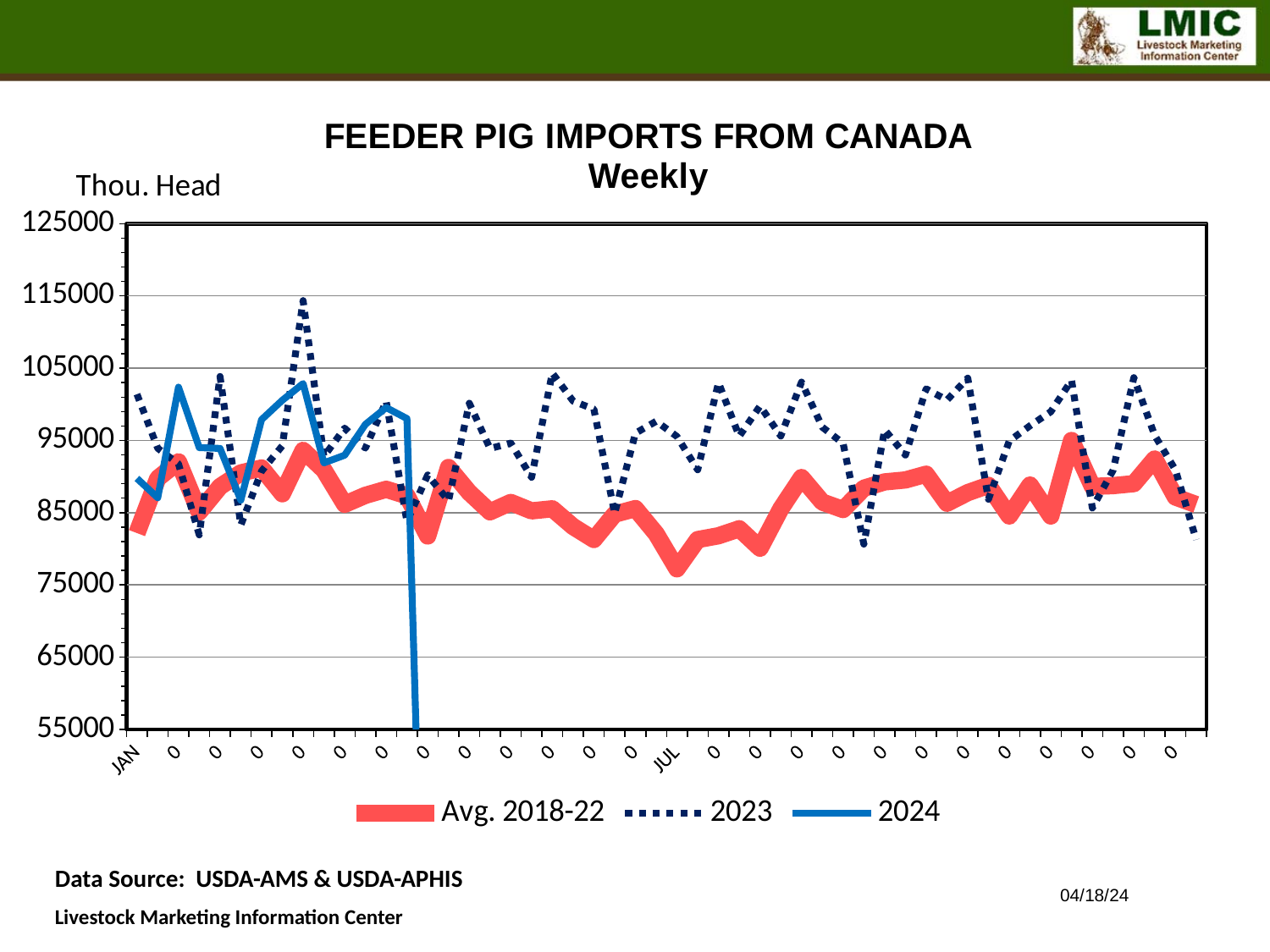
Is the Avg. 2018-22 value at JAN greater or less than 85000? less Is the highest value of the 2023 series greater or less than 105000? greater Which series has a higher peak value: 2023 or 2024? 2023 At JAN, which is larger: the 2023 value or the Avg. 2018-22 value? 2023 What unit label is shown above the vertical axis? Thou. Head How many series does the legend list? 3 Is the lowest value of the Avg. 2018-22 series greater or less than 85000? less Which series reaches the highest value anywhere on the chart? 2023 What kind of chart is shown on the slide? Line chart What is the title of the chart? FEEDER PIG IMPORTS FROM CANADA Weekly